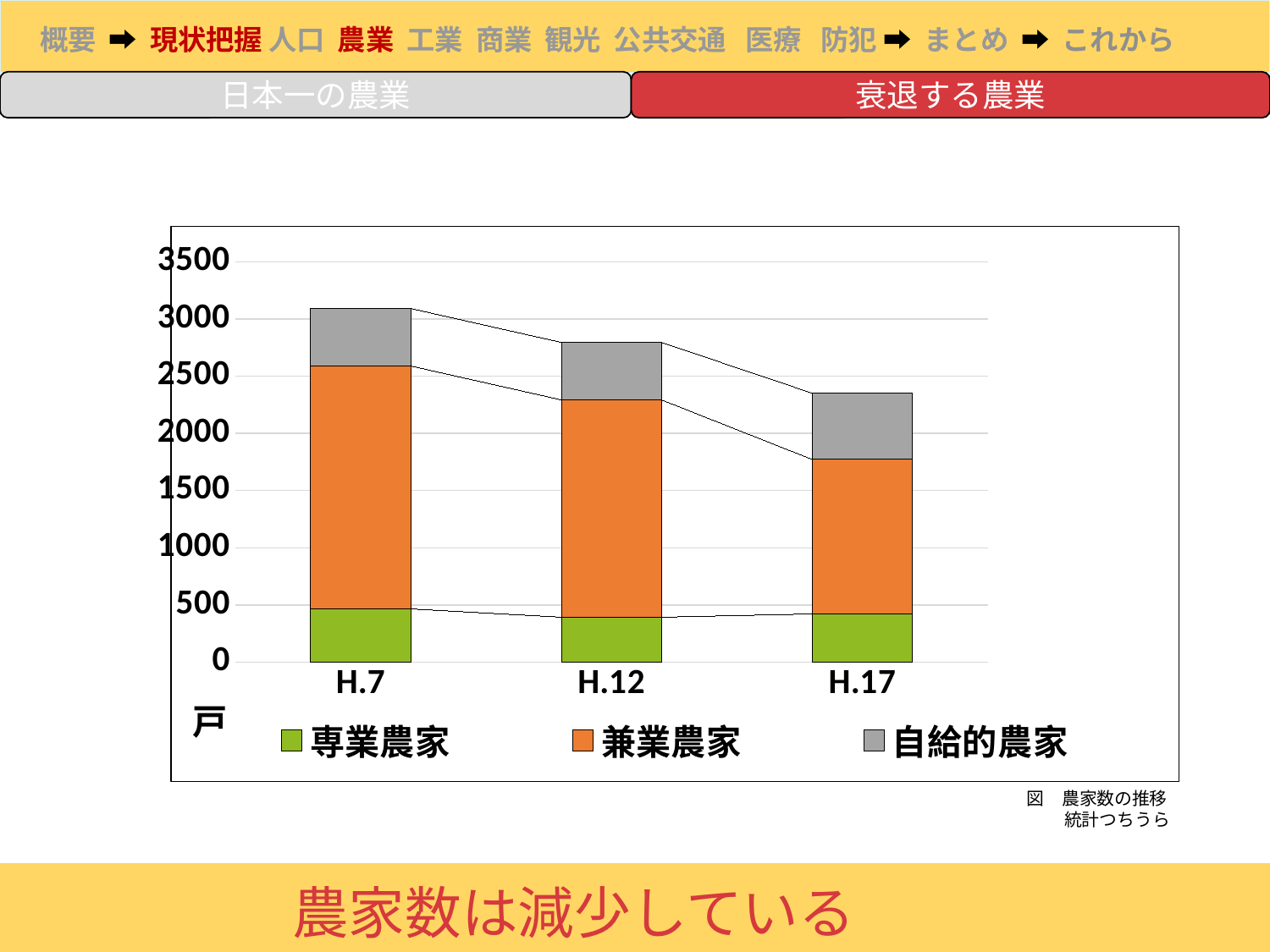
Is the value for 専業農家 in H.12 greater or less than 500? less What are the three series listed in the chart's legend? 専業農家, 兼業農家, 自給的農家 What kind of chart is shown on the slide? bar chart Which is larger in H.7, the 兼業農家 segment or the 専業農家 segment? 兼業農家 Is the total bar height for H.12 greater or less than 3000? less Is the total bar height for H.7 greater or less than 3000? greater Do the total bar heights rise or fall from H.7 to H.17? fall Which year has the lowest total number of farm households? H.17 How many categories (years) are shown on the x axis of the chart? 3 Which year has the highest total number of farm households? H.7 How many series does the chart's legend list? 3